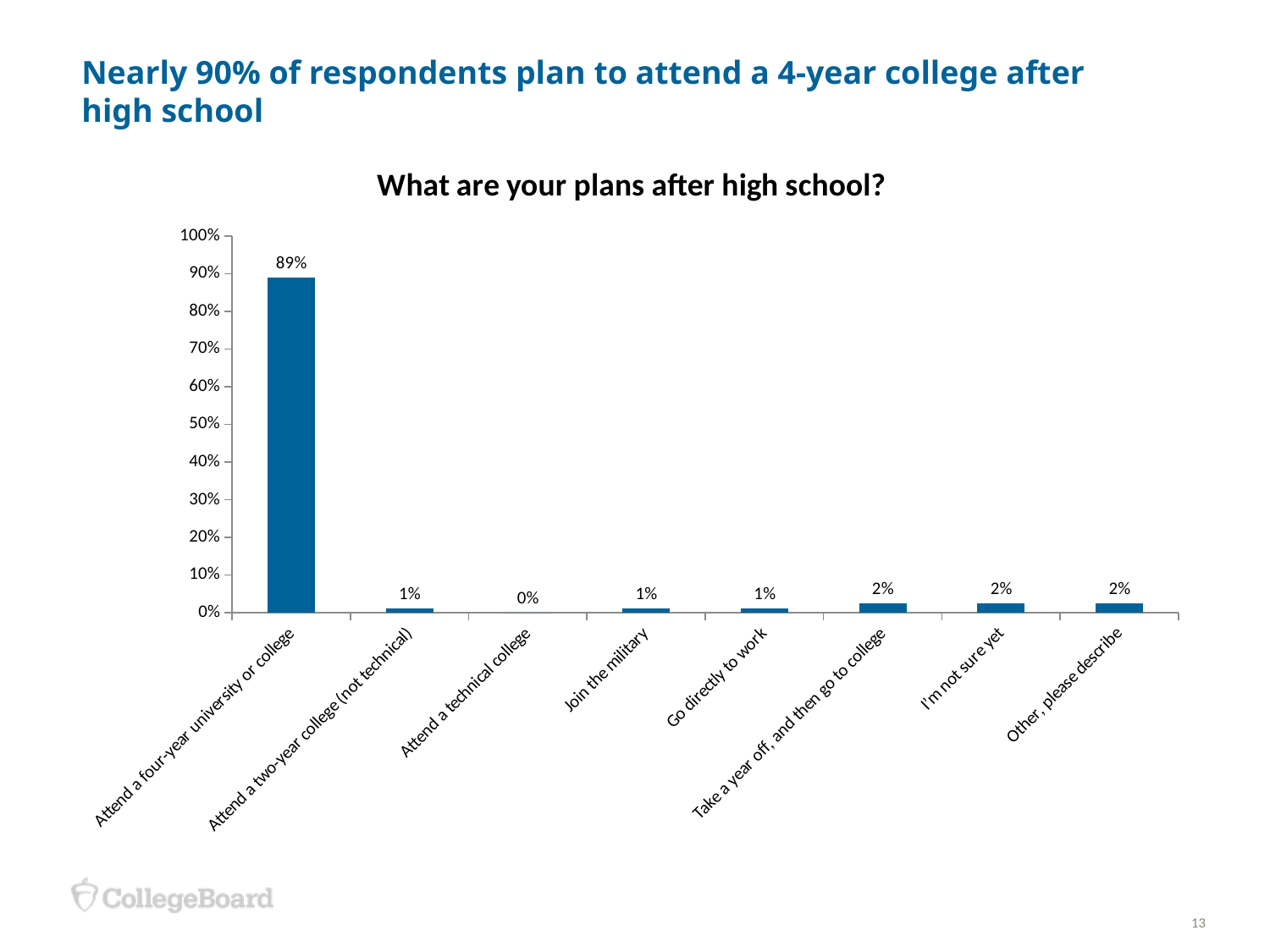
What is the value for "Join the military"? 1% What percentage of respondents plan to attend a four-year university or college? 89% Which category has the lowest value? Attend a technical college How many categories are shown on the x axis? 8 What is the difference between the value for "Attend a four-year university or college" and the value for "Go directly to work"? 88% What is the title of the chart? What are your plans after high school? Which category has the highest value? Attend a four-year university or college Which is larger: the value for "Take a year off, and then go to college" or the value for "Attend a two-year college (not technical)"? Take a year off, and then go to college Is the value for "Attend a four-year university or college" greater or less than 80%? greater What is the value for "Attend a technical college"? 0% What kind of chart is shown on the slide? bar chart What is the value for "I'm not sure yet"? 2%